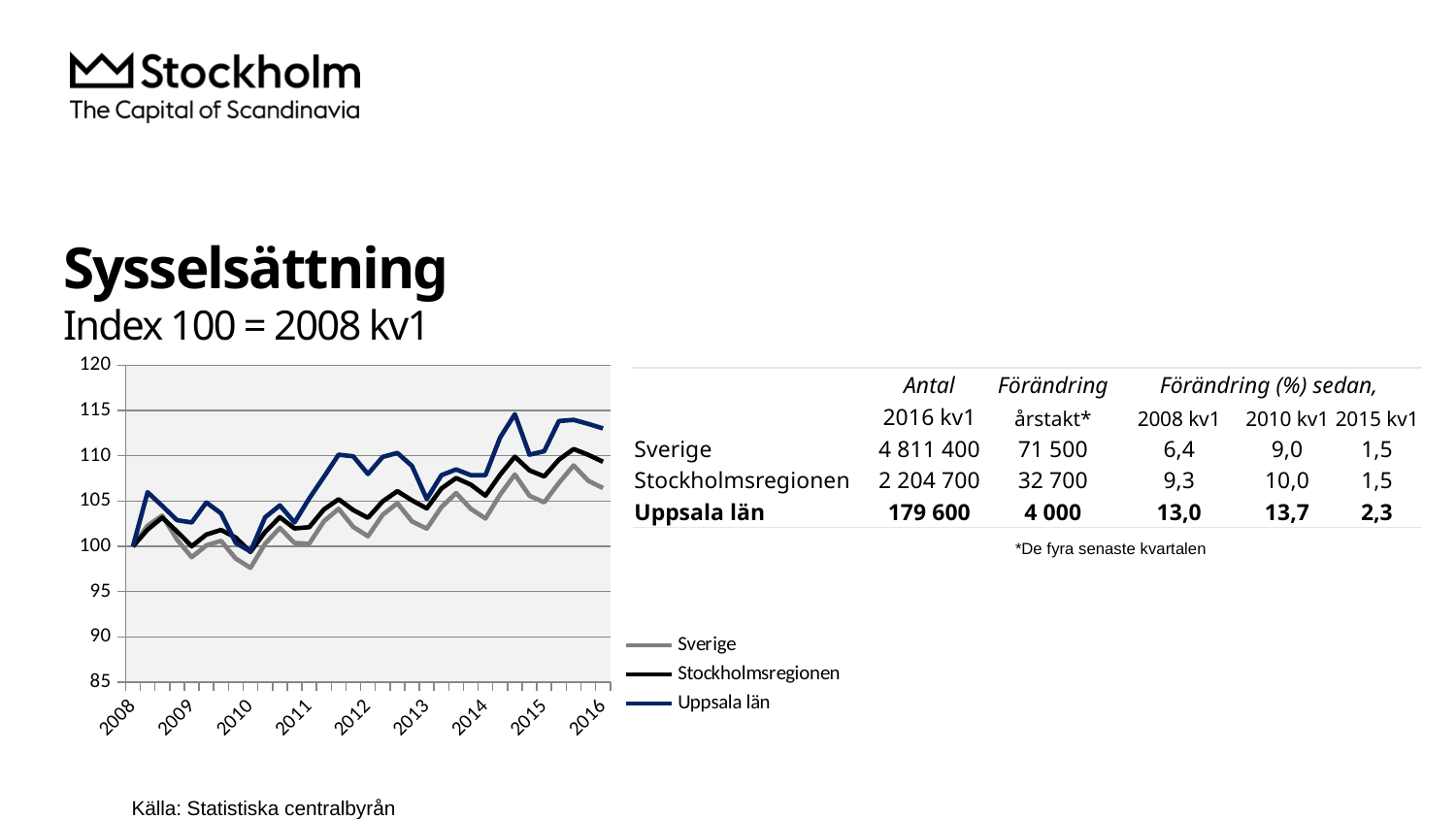
Which series has the lowest index value at the end of the chart in 2016? Sverige Is the index value for Sverige in 2016 greater or less than 105? greater What is the index base stated in the chart subtitle? Index 100 = 2008 kv1 Do the index values for Uppsala län generally rise or fall from 2008 to 2016? rise Is the lowest index value for Sverige around 2010 greater or less than 100? less Is the index value for Uppsala län in 2016 greater or less than 110? greater How many series does the chart legend list? 3 Which series has the highest index value at the end of the chart in 2016? Uppsala län At the end of the chart in 2016, is the index for Uppsala län or for Sverige larger? Uppsala län How many year labels are shown on the x axis of the chart? 9 What kind of chart is shown on the slide? line chart Which series are listed in the chart legend? Sverige, Stockholmsregionen, Uppsala län